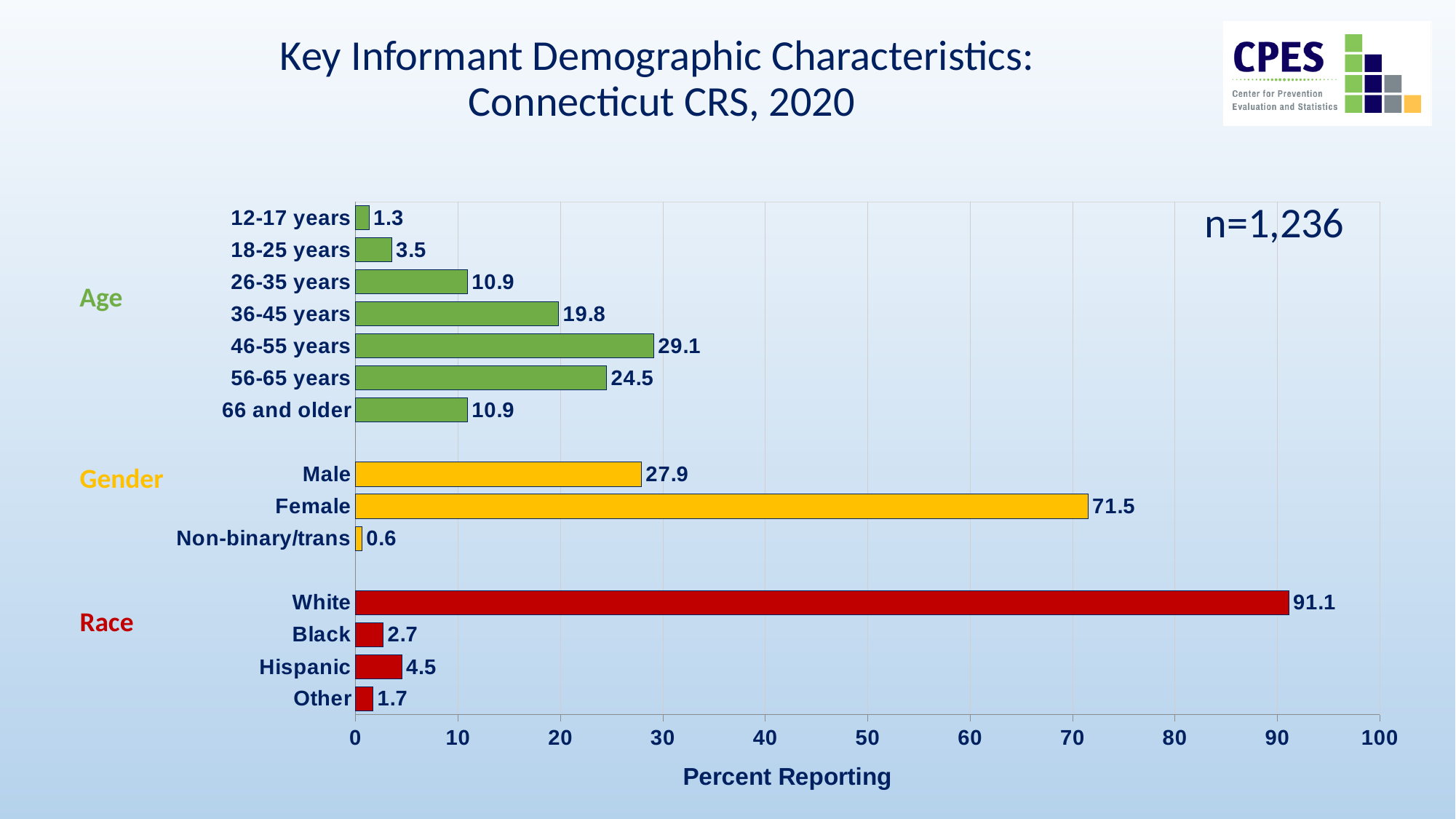
Which race category has the lowest percent reporting? Other What is the difference in percent reporting between the 46-55 years and 56-65 years age groups? 4.6 What is the difference in percent reporting between Female and Male? 43.6 What kind of chart is shown on the slide? Bar chart What percent of key informants were aged 46-55 years? 29.1 How many age group categories are shown in the chart? 7 Which has a higher percent reporting, 36-45 years or 66 and older? 36-45 years What percent of key informants were Hispanic? 4.5 What percent of key informants were Female? 71.5 What is the sample size (n) shown on the chart? n=1,236 Which age group has the highest percent reporting? 46-55 years What is the label of the horizontal axis? Percent Reporting